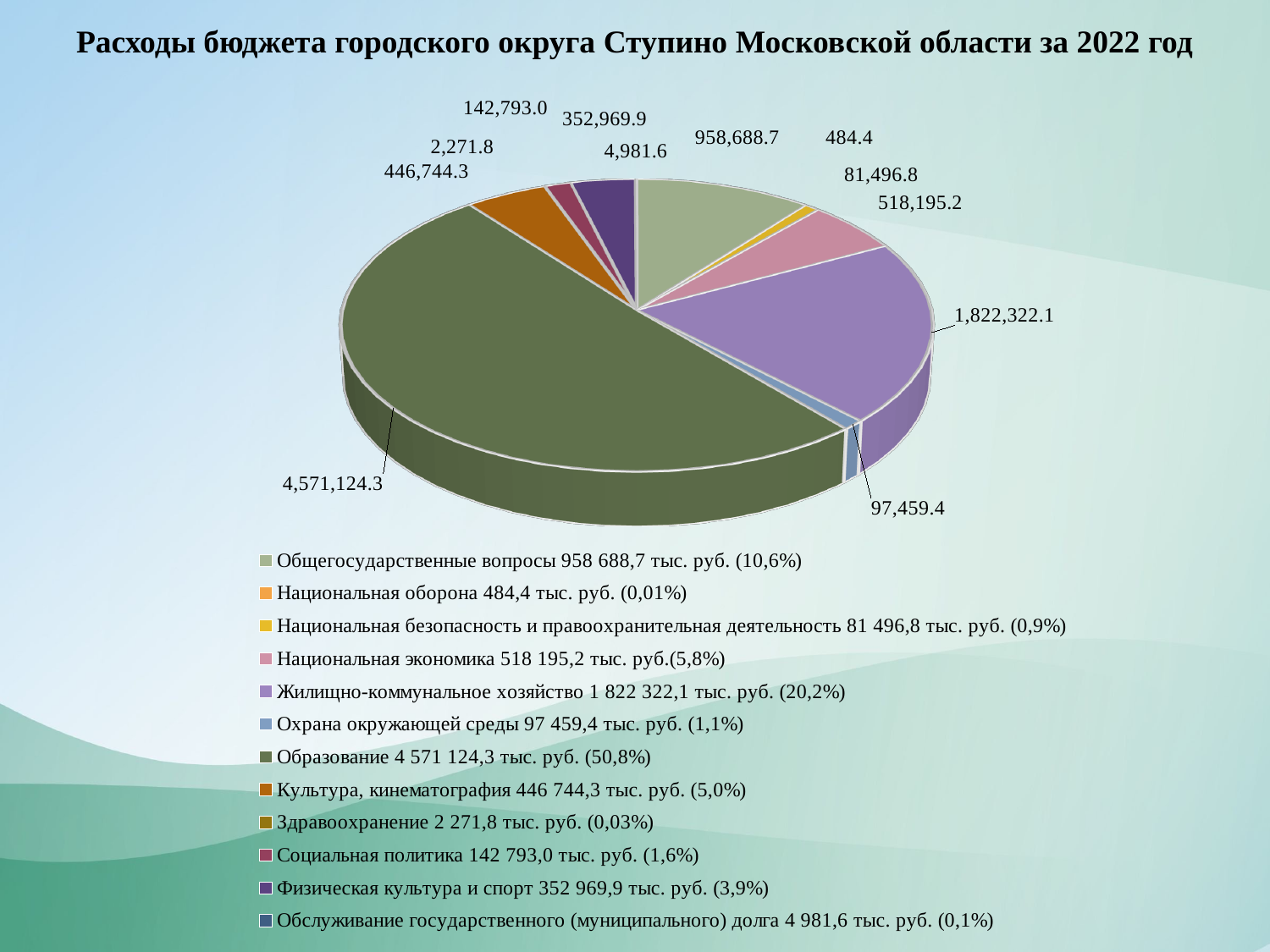
Which category has the smallest value in the pie chart? Национальная оборона What is the difference between the value for Общегосударственные вопросы (958,688.7) and the value for Национальная экономика (518,195.2)? 440,493.5 What kind of chart is shown on the slide? Pie chart What is the title of the slide? Расходы бюджета городского округа Ступино Московской области за 2022 год How many expenditure categories does the pie chart show? 12 What is the value shown for Национальная экономика? 518,195.2 What share of the budget expenditures does Жилищно-коммунальное хозяйство account for, according to the legend? 20,2% What share of the budget expenditures does Образование account for, according to the legend? 50,8% What is the value shown for Жилищно-коммунальное хозяйство? 1,822,322.1 Which category has the largest share of the budget expenditures? Образование Which is larger: the value for Общегосударственные вопросы or the value for Национальная экономика? Общегосударственные вопросы What is the value shown for Культура, кинематография? 446,744.3